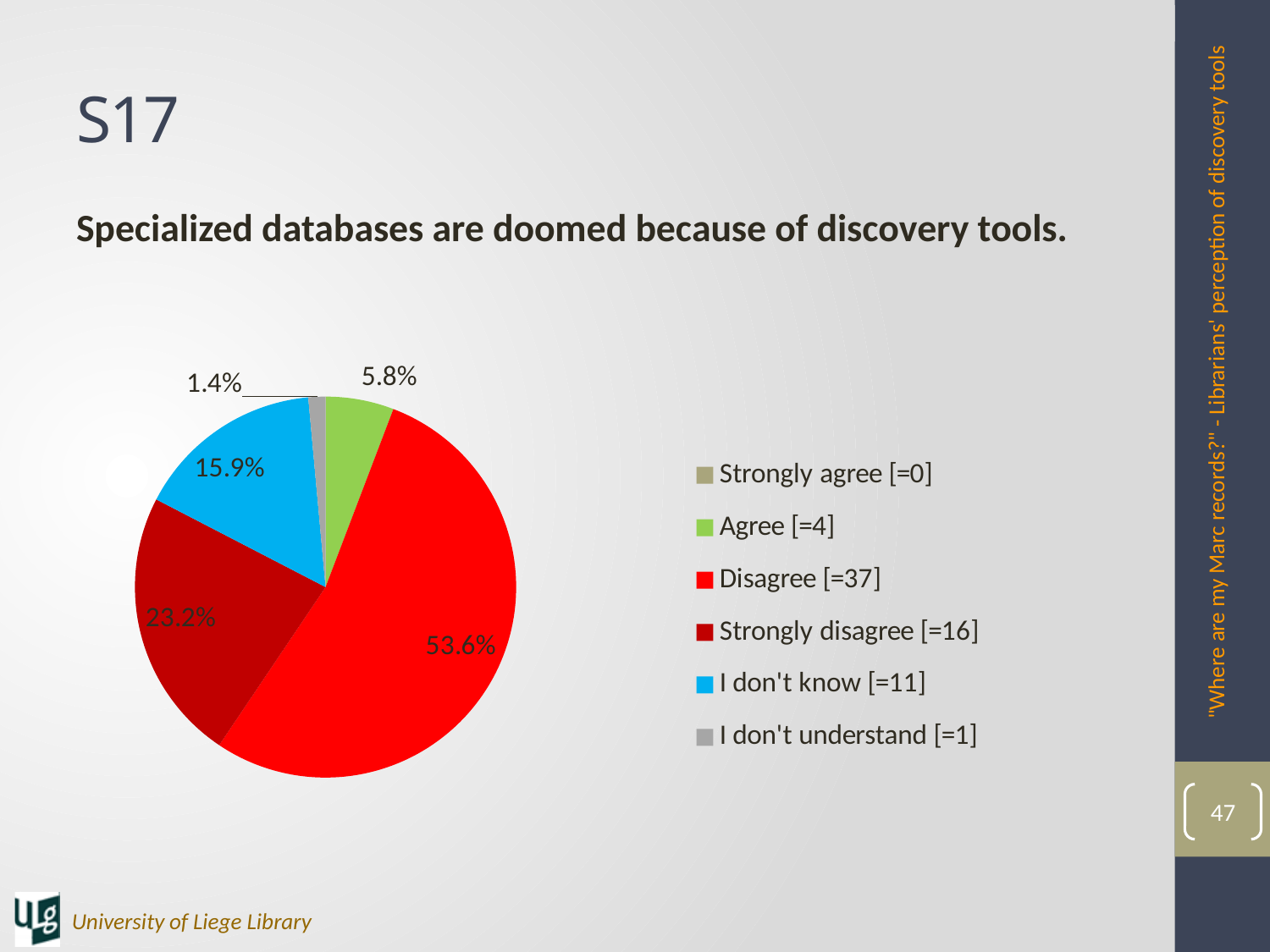
What percentage of the pie is labelled for Strongly disagree? 23.2% What percentage of the pie is labelled for Disagree? 53.6% According to the legend, how many respondents chose Strongly disagree? 16 Which response category has the largest share of the pie? Disagree What percentage of the pie is labelled for Agree? 5.8% What percentage of the pie is labelled for I don't know? 15.9% What is the difference in percentage points between the Disagree and Strongly disagree slices? 30.4 What type of chart is shown on the slide? pie chart What percentage of the pie is labelled for I don't understand? 1.4% How many entries does the legend list? 6 Which response category has the smallest share of the pie among those with a visible slice? I don't understand Which slice is larger, I don't know or Agree? I don't know